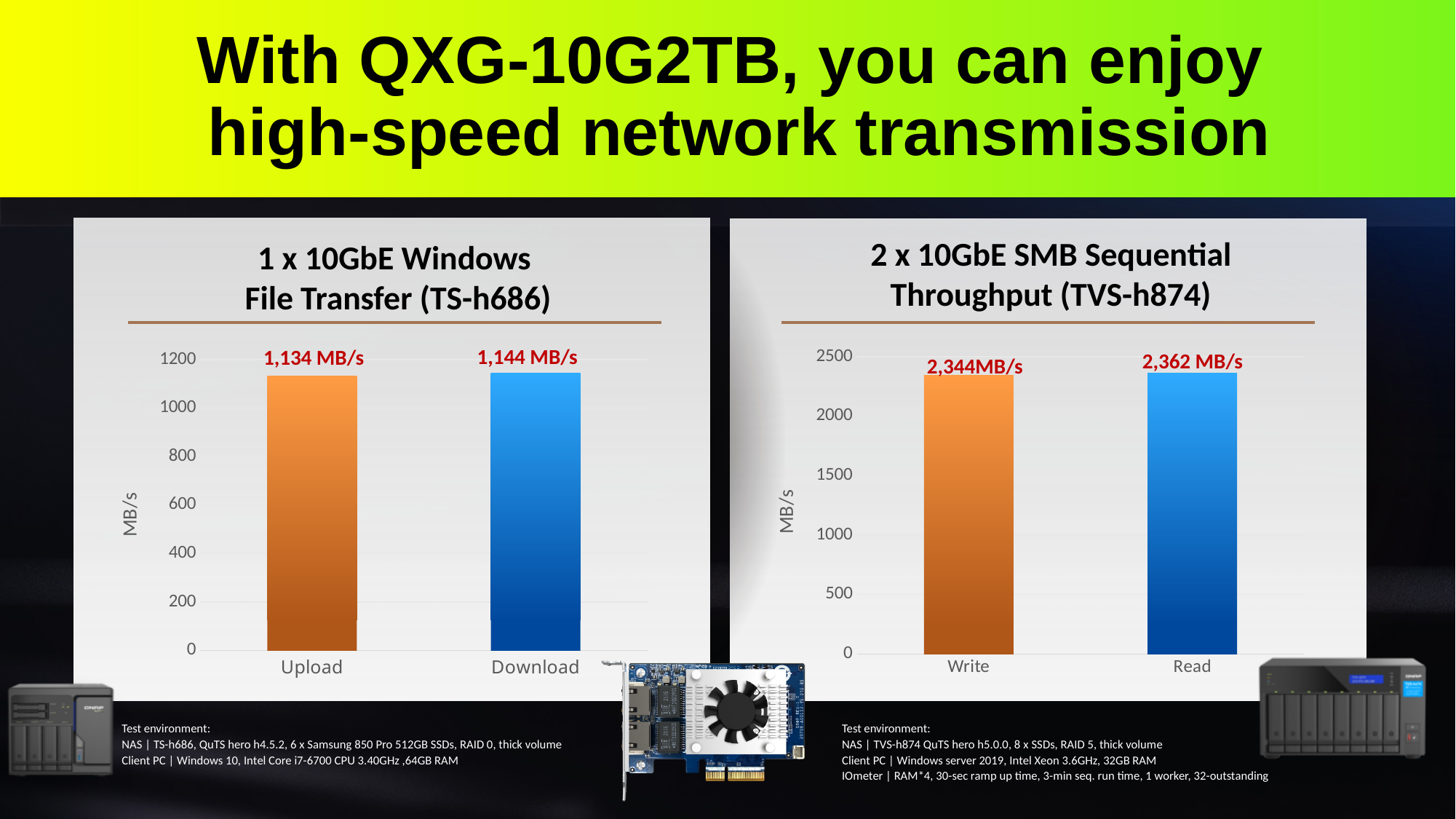
In the '1 x 10GbE Windows File Transfer (TS-h686)' chart, which category has the higher value according to the data labels? Download What is the y-axis label of the '1 x 10GbE Windows File Transfer (TS-h686)' chart? MB/s What kind of chart is the '2 x 10GbE SMB Sequential Throughput (TVS-h874)' chart? Bar chart How many categories are shown in the '1 x 10GbE Windows File Transfer (TS-h686)' chart? 2 In the '2 x 10GbE SMB Sequential Throughput (TVS-h874)' chart, is the value for Write greater or less than 2000? greater In the '2 x 10GbE SMB Sequential Throughput (TVS-h874)' chart, what is the value for Write? 2,344MB/s In the '1 x 10GbE Windows File Transfer (TS-h686)' chart, what is the value for Download? 1,144 MB/s In the '2 x 10GbE SMB Sequential Throughput (TVS-h874)' chart, what is the difference between the Read and Write values? 18 MB/s In the '1 x 10GbE Windows File Transfer (TS-h686)' chart, what is the difference between the Download and Upload values? 10 MB/s In the '2 x 10GbE SMB Sequential Throughput (TVS-h874)' chart, what is the value for Read? 2,362 MB/s In the '1 x 10GbE Windows File Transfer (TS-h686)' chart, what is the value for Upload? 1,134 MB/s In the '2 x 10GbE SMB Sequential Throughput (TVS-h874)' chart, which category has the lower value according to the data labels? Write